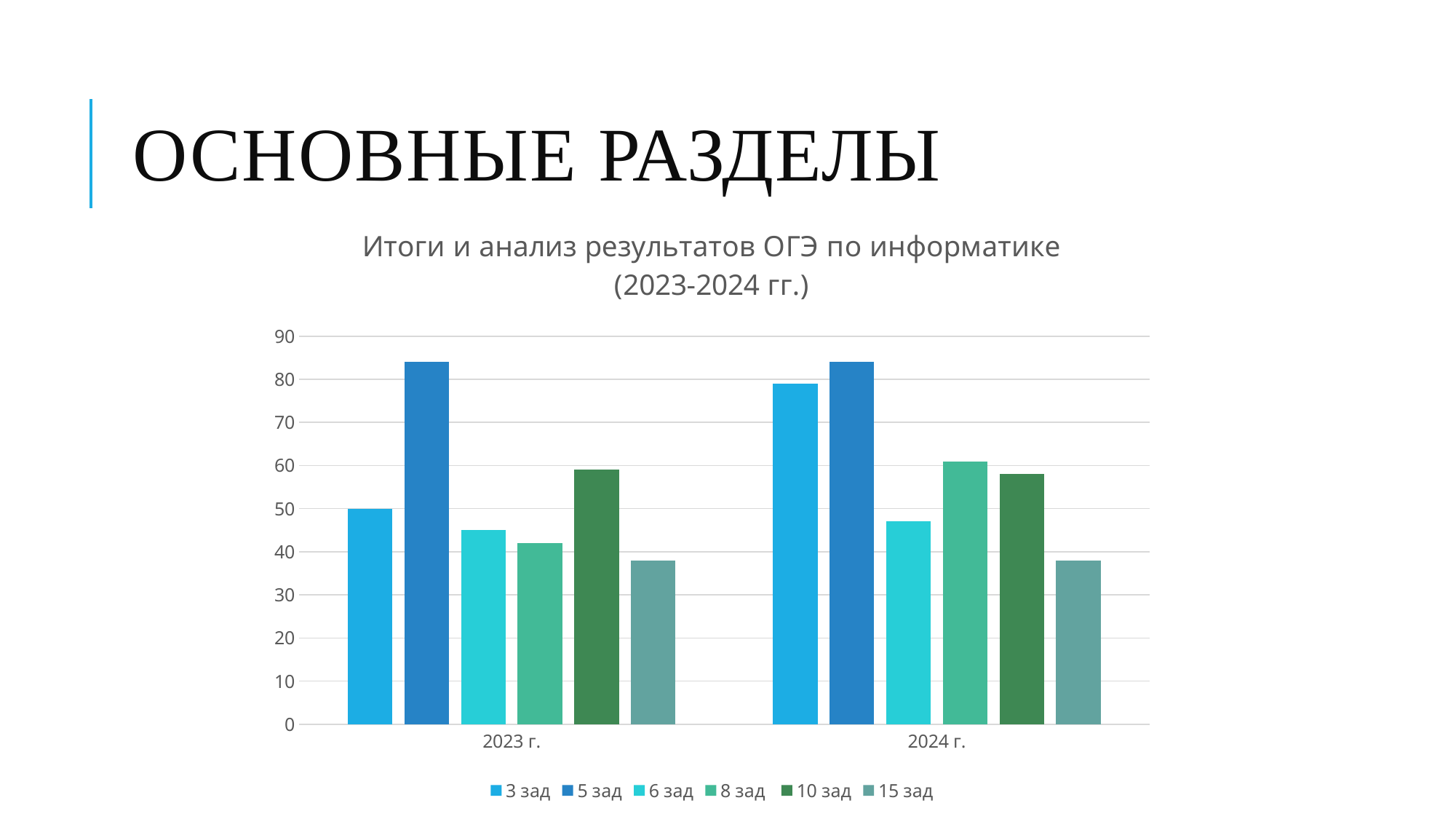
Is the value for 3 зад in 2024 г. greater or less than 70? greater For 3 зад, which year has the larger value, 2023 г. or 2024 г.? 2024 г. Is the value for 5 зад in 2023 г. greater or less than 80? greater Is the value for 15 зад in 2024 г. greater or less than 40? less Which series has the highest value for 2024 г.? 5 зад What is the title of the chart? Итоги и анализ результатов ОГЭ по информатике (2023-2024 гг.) Which series has the highest value for 2023 г.? 5 зад Which series has the lowest value for 2024 г.? 15 зад How many series does the legend list? 6 How many year categories are shown on the x axis? 2 What kind of chart is shown on the slide? bar chart